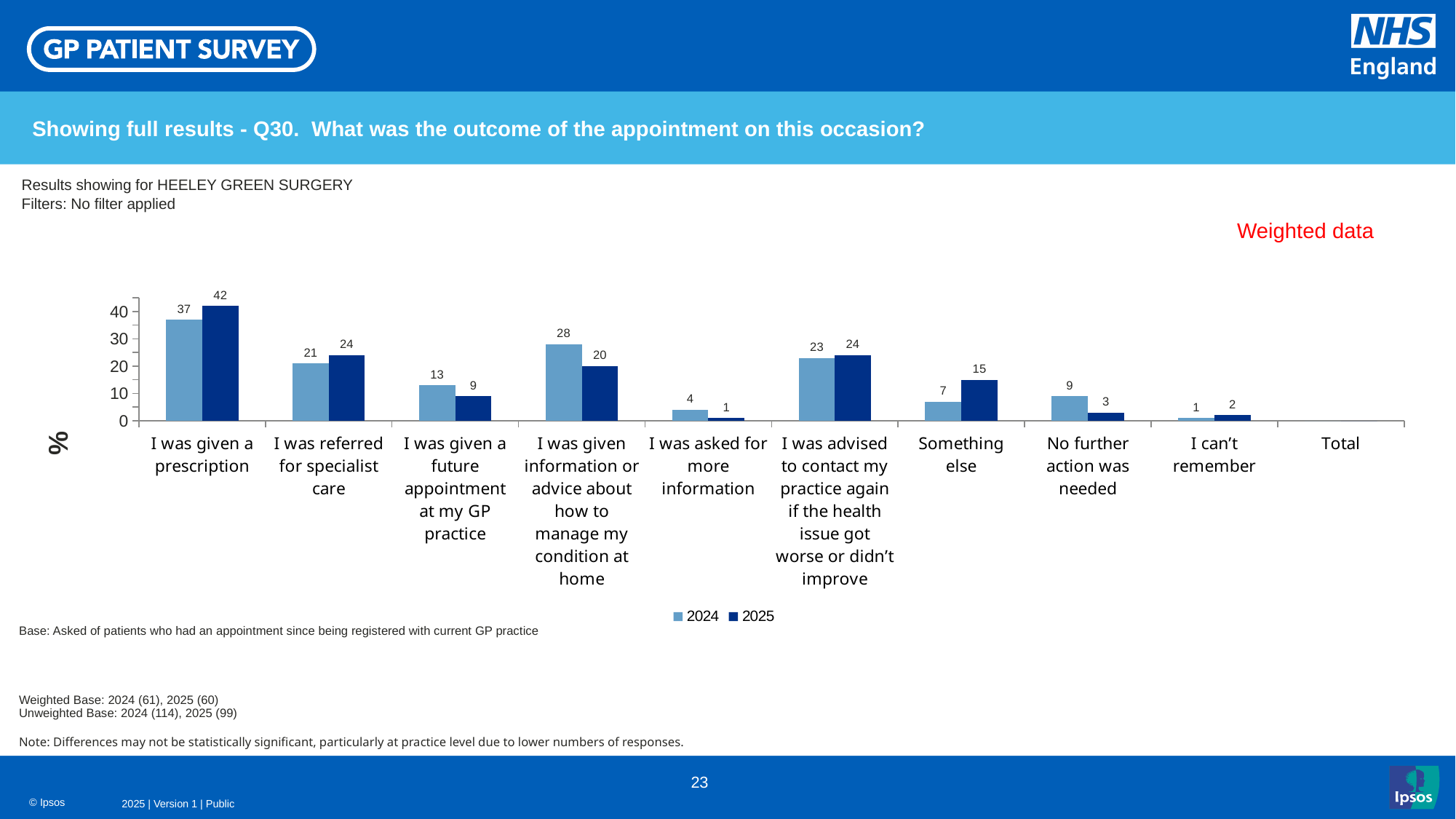
Which is larger for 'I was referred for specialist care': the 2024 value or the 2025 value? 2025 What is the 2025 value for 'I was given a prescription'? 42 What kind of chart is shown on the slide? Bar chart What is the difference between the 2024 and 2025 values for 'No further action was needed'? 6 What is the 2024 value for 'I was given information or advice about how to manage my condition at home'? 28 What is the 2025 value for 'I was asked for more information'? 1 Which category has the highest 2025 value? I was given a prescription Which is larger for 'I was given a future appointment at my GP practice': the 2024 value or the 2025 value? 2024 Which category has the lowest 2024 value? I can't remember What is the difference between the 2024 and 2025 values for 'I was given a prescription'? 5 How many series does the legend list? 2 What is the 2025 value for 'Something else'? 15